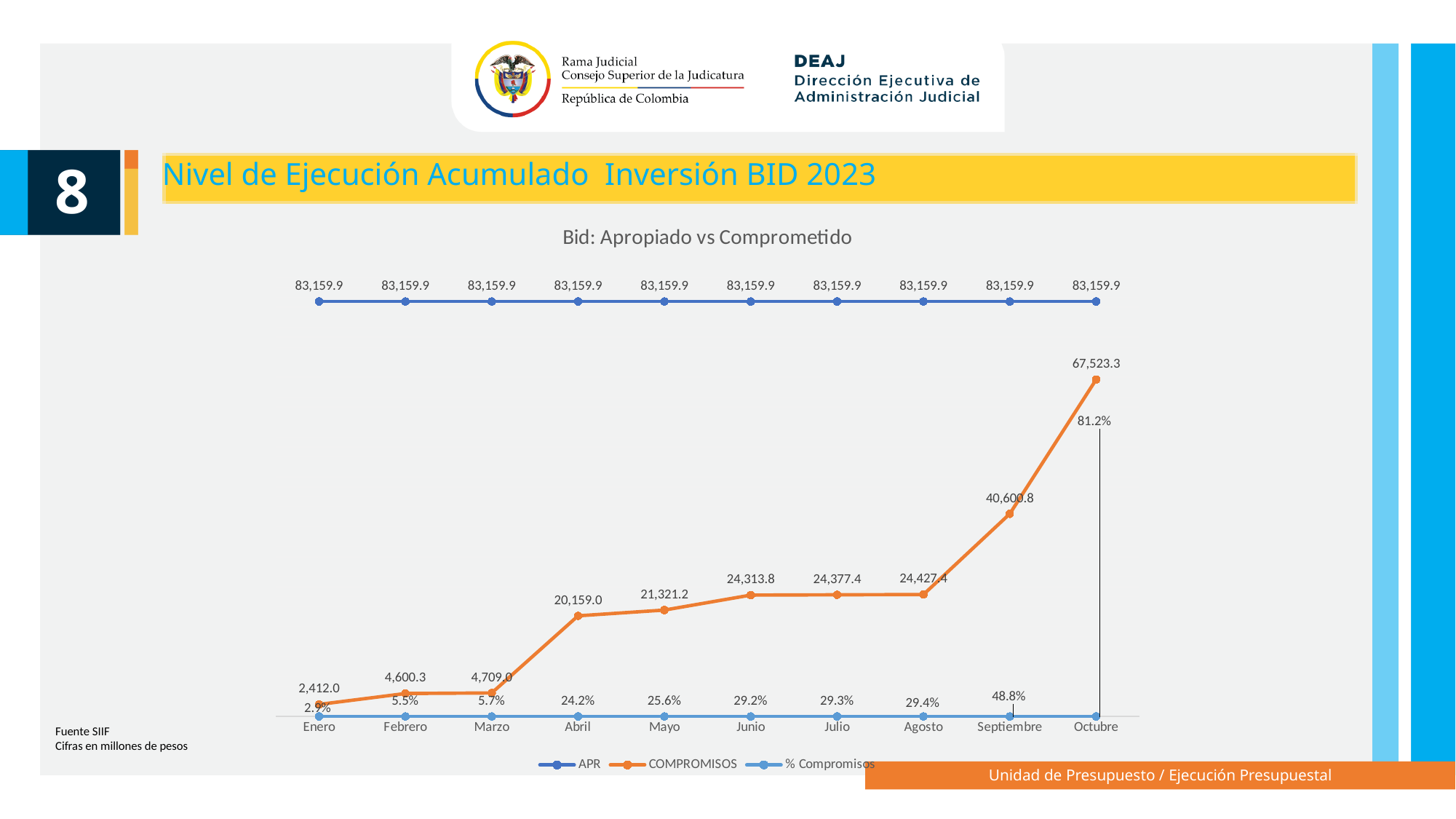
What is the APR value for Enero? 83,159.9 What kind of chart is shown on the slide? Line chart Which is larger, the COMPROMISOS value for Abril or for Marzo? Abril How many months are plotted along the x axis? 10 Does the COMPROMISOS series rise or fall from Enero to Octubre? Rise How many series does the legend list? 3 What is the % Compromisos value for Septiembre? 48.8% In which month is the COMPROMISOS value highest? Octubre What is the COMPROMISOS value for Octubre? 67,523.3 What is the difference between the COMPROMISOS values for Octubre and Septiembre? 26,922.5 What is the title of the chart? Bid: Apropiado vs Comprometido In which month is the COMPROMISOS value lowest? Enero